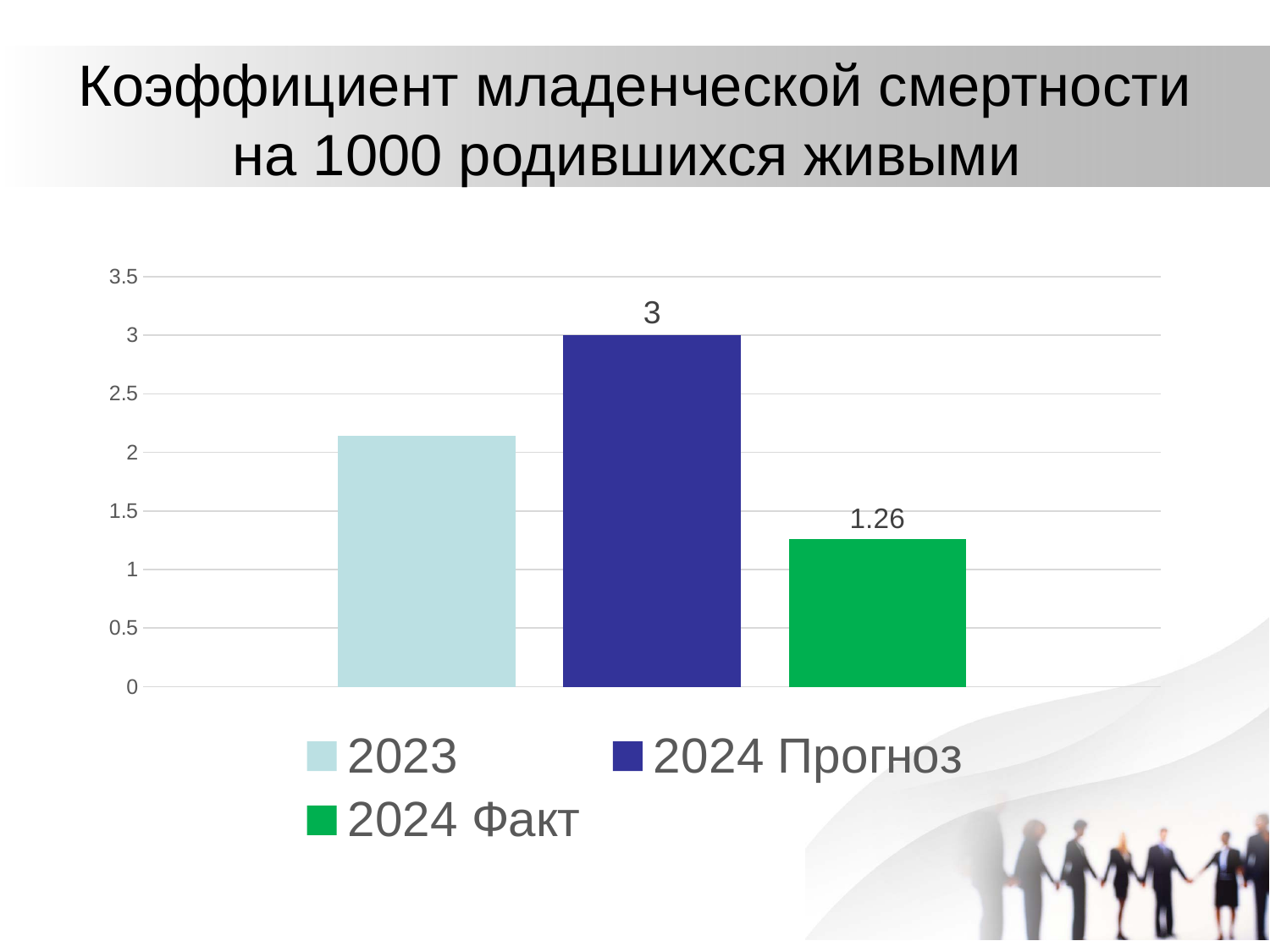
Is the value for 2023 greater or less than 2.5? less What is the value for 2024 Факт? 1.26 Which is larger, the value for 2023 or the value for 2024 Прогноз? 2024 Прогноз Which series has the lowest value? 2024 Факт What is the value for 2024 Прогноз? 3 What is the title of the slide? Коэффициент младенческой смертности на 1000 родившихся живыми Which is larger, the value for 2023 or the value for 2024 Факт? 2023 How many series does the legend list? 3 Is the value for 2023 greater or less than 2? greater What kind of chart is shown on the slide? bar chart Which series has the highest value? 2024 Прогноз What is the difference between the 2024 Прогноз value and the 2024 Факт value? 1.74